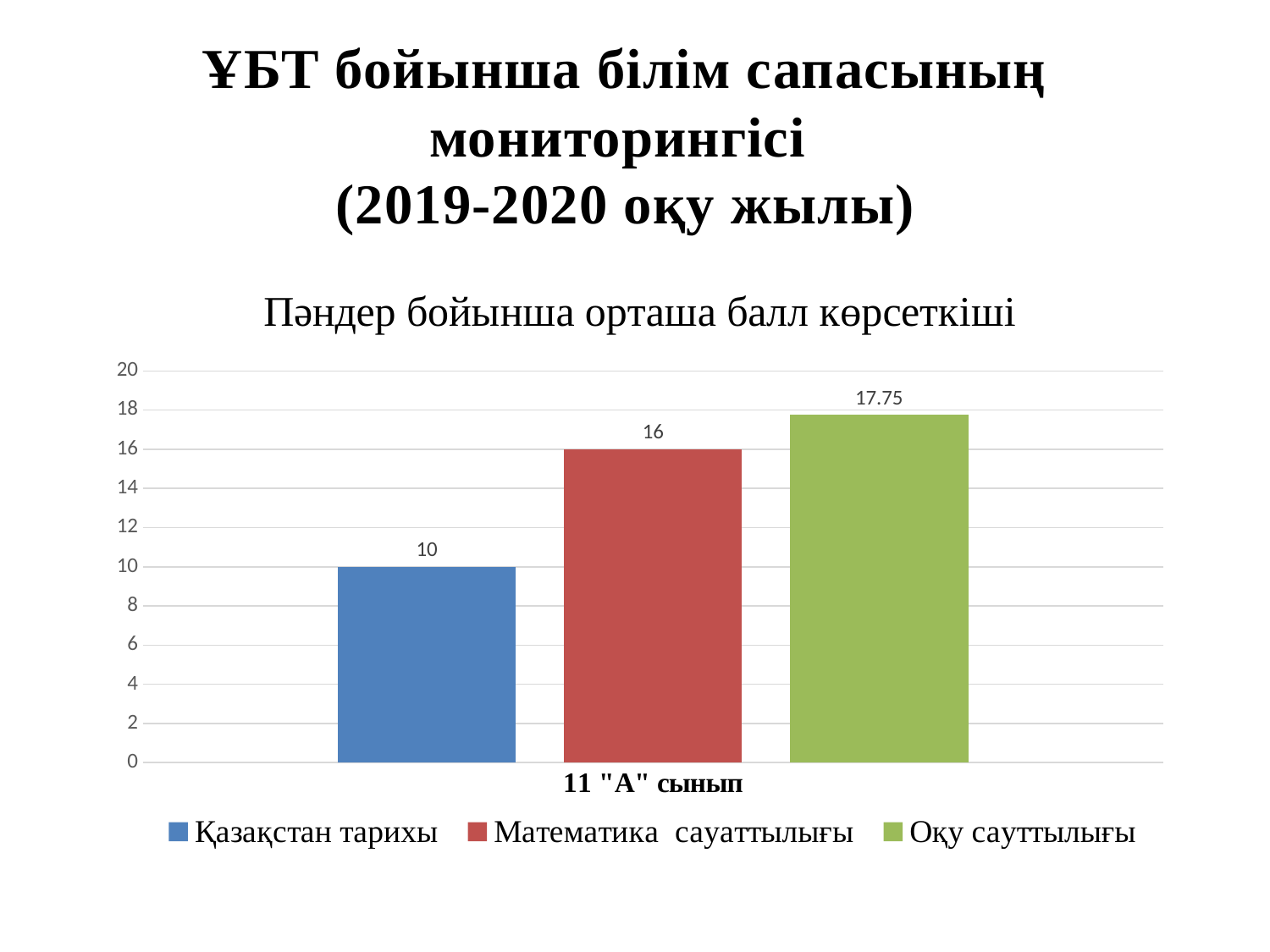
What is the category label on the x axis? 11 "А" сынып What is the title of the chart? Пәндер бойынша орташа балл көрсеткіші Which series has the lowest value? Қазақстан тарихы What is the difference between the values for Математика сауаттылығы and Қазақстан тарихы? 6 What is the difference between the values for Оқу сауттылығы and Математика сауаттылығы? 1.75 What is the value for Қазақстан тарихы? 10 What kind of chart is shown? bar chart How many series does the legend list? 3 Which series has the highest value? Оқу сауттылығы What is the value for Оқу сауттылығы? 17.75 Which is larger, the value for Қазақстан тарихы or the value for Математика сауаттылығы? Математика сауаттылығы What is the value for Математика сауаттылығы? 16